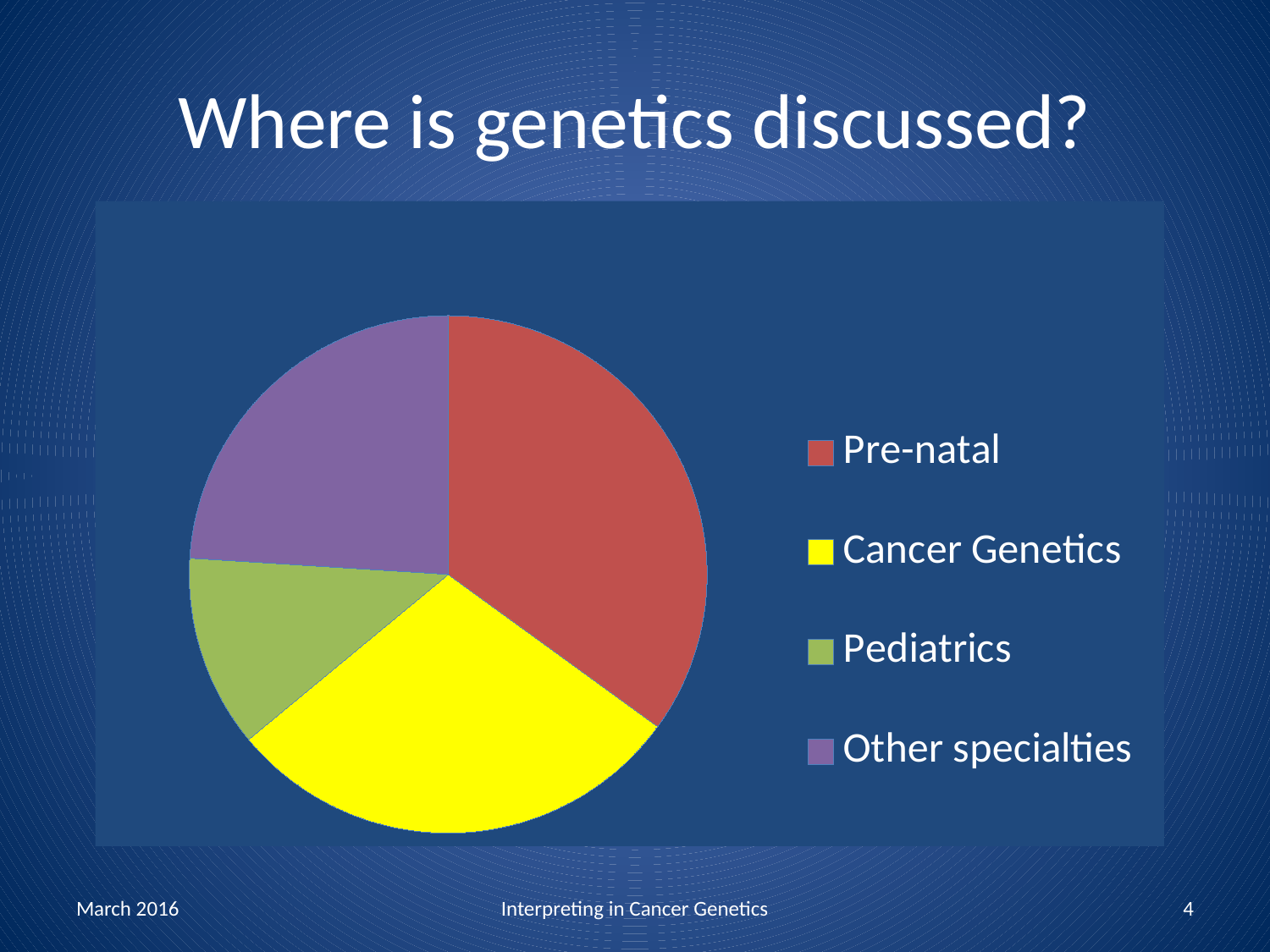
What is the title of the slide containing the pie chart? Where is genetics discussed? What kind of chart is shown on the slide? pie chart Which slice is larger, Cancer Genetics or Other specialties? Cancer Genetics Which slice is larger, Pre-natal or Cancer Genetics? Pre-natal Which slice is larger, Other specialties or Pediatrics? Other specialties Which category has the smallest slice of the pie? Pediatrics What colour is the Cancer Genetics slice in the pie chart? yellow How many slices does the pie chart have? 4 Which category has the largest slice of the pie? Pre-natal